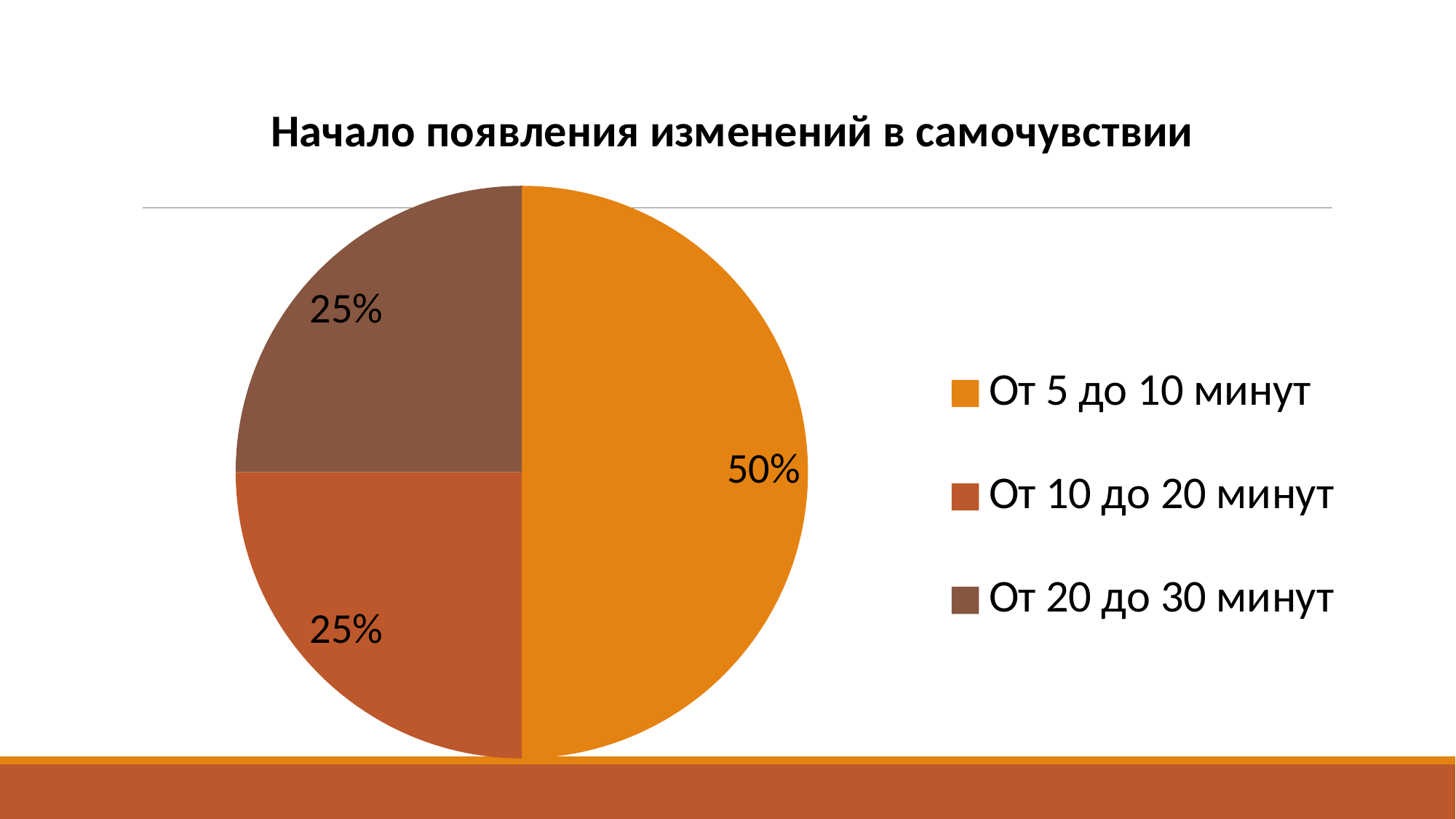
What is the title of the chart? Начало появления изменений в самочувствии How many slices does the pie chart have? 3 What colour is the slice for "От 5 до 10 минут"? orange What is the combined share of "От 10 до 20 минут" and "От 20 до 30 минут"? 50% Which category has the largest slice of the pie? От 5 до 10 минут What share of the pie is labelled "От 20 до 30 минут"? 25% What share of the pie is labelled "От 5 до 10 минут"? 50% What kind of chart is shown on the slide? pie chart What share of the pie is labelled "От 10 до 20 минут"? 25% How many entries does the legend list? 3 Which is larger: the share for "От 5 до 10 минут" or the share for "От 20 до 30 минут"? От 5 до 10 минут What is the difference between the share for "От 5 до 10 минут" and the share for "От 10 до 20 минут"? 25%